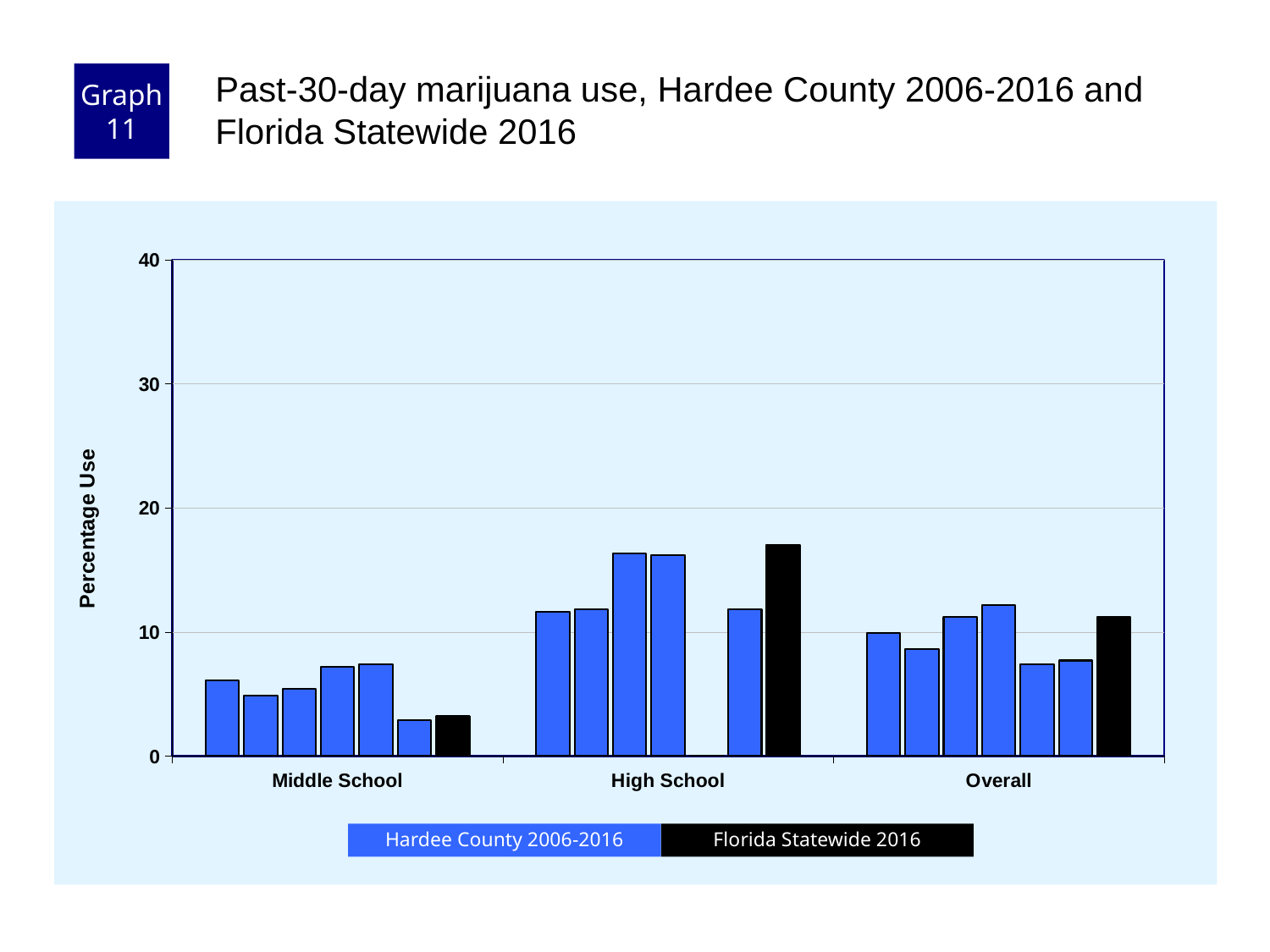
How many series does the legend list? 2 Which category has the lowest Florida Statewide 2016 bar? Middle School Is the Florida Statewide 2016 value for Middle School greater or less than 10? less Are all the Middle School bars above or below 10? below What is the label on the y axis? Percentage Use How many categories are shown on the x axis? 3 Which category has the highest Florida Statewide 2016 bar? High School Is the Florida Statewide 2016 value for Overall greater or less than 10? greater What kind of chart is shown on the slide? bar chart Which colour represents Florida Statewide 2016 in the legend? black Which is larger, the Florida Statewide 2016 value for High School or for Overall? High School